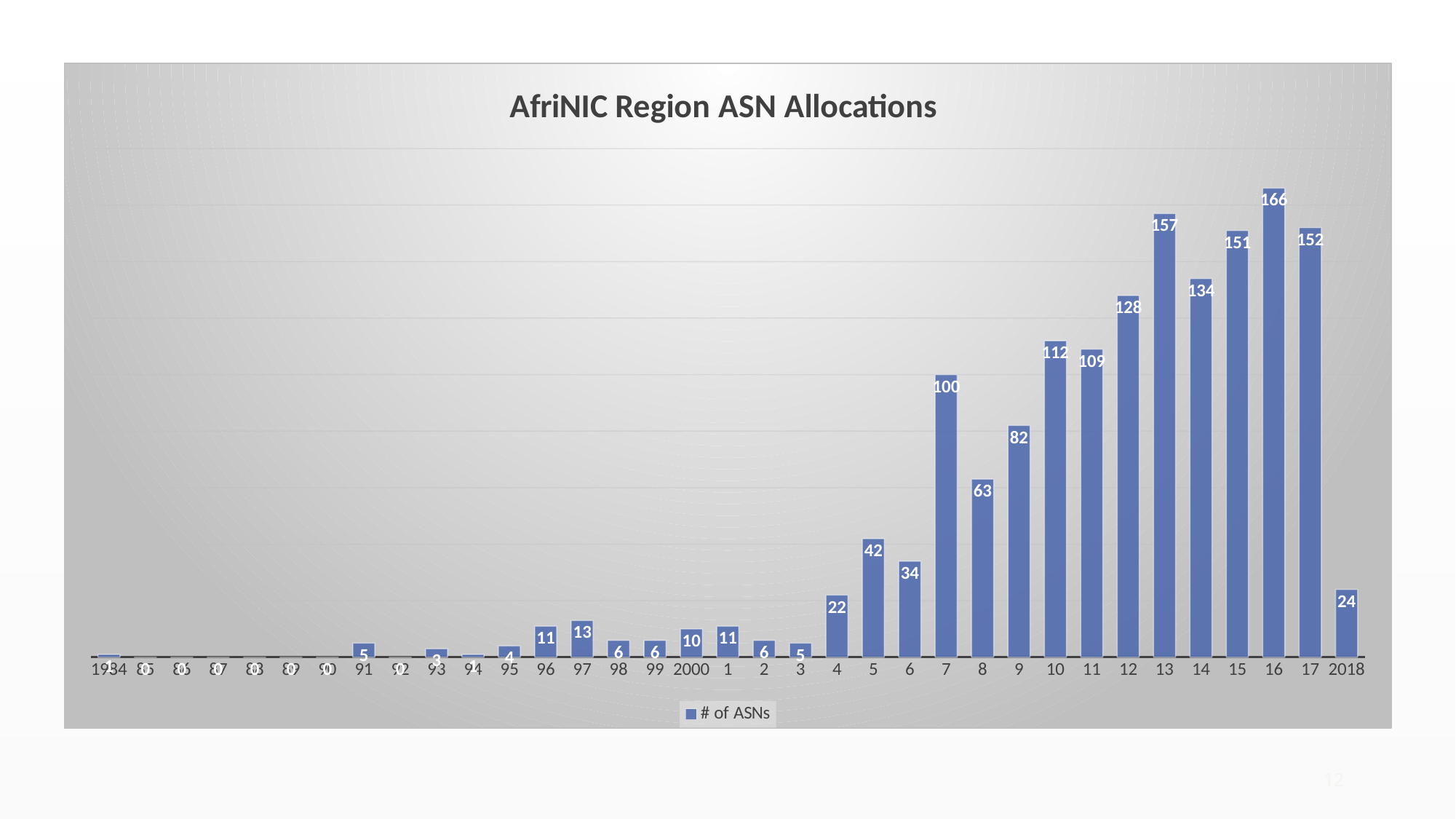
Which has more ASNs, 2008 (8) or 2009 (9)? 9 Do the values rise or fall from 2004 (4) to 2007 (7)? rise What type of chart is shown on the slide? bar chart What is the difference in ASNs between 2013 (13) and 2014 (14)? 23 What is the title of the chart? AfriNIC Region ASN Allocations Which year has the highest number of ASNs? 16 How many series does the legend list? 1 What is the number of ASNs for 2018? 24 What is the number of ASNs for 2007 (labelled 7)? 100 What is the number of ASNs for 2000? 10 What is the number of ASNs for 2016 (labelled 16)? 166 What is the difference in ASNs between 2016 (16) and 2017 (17)? 14